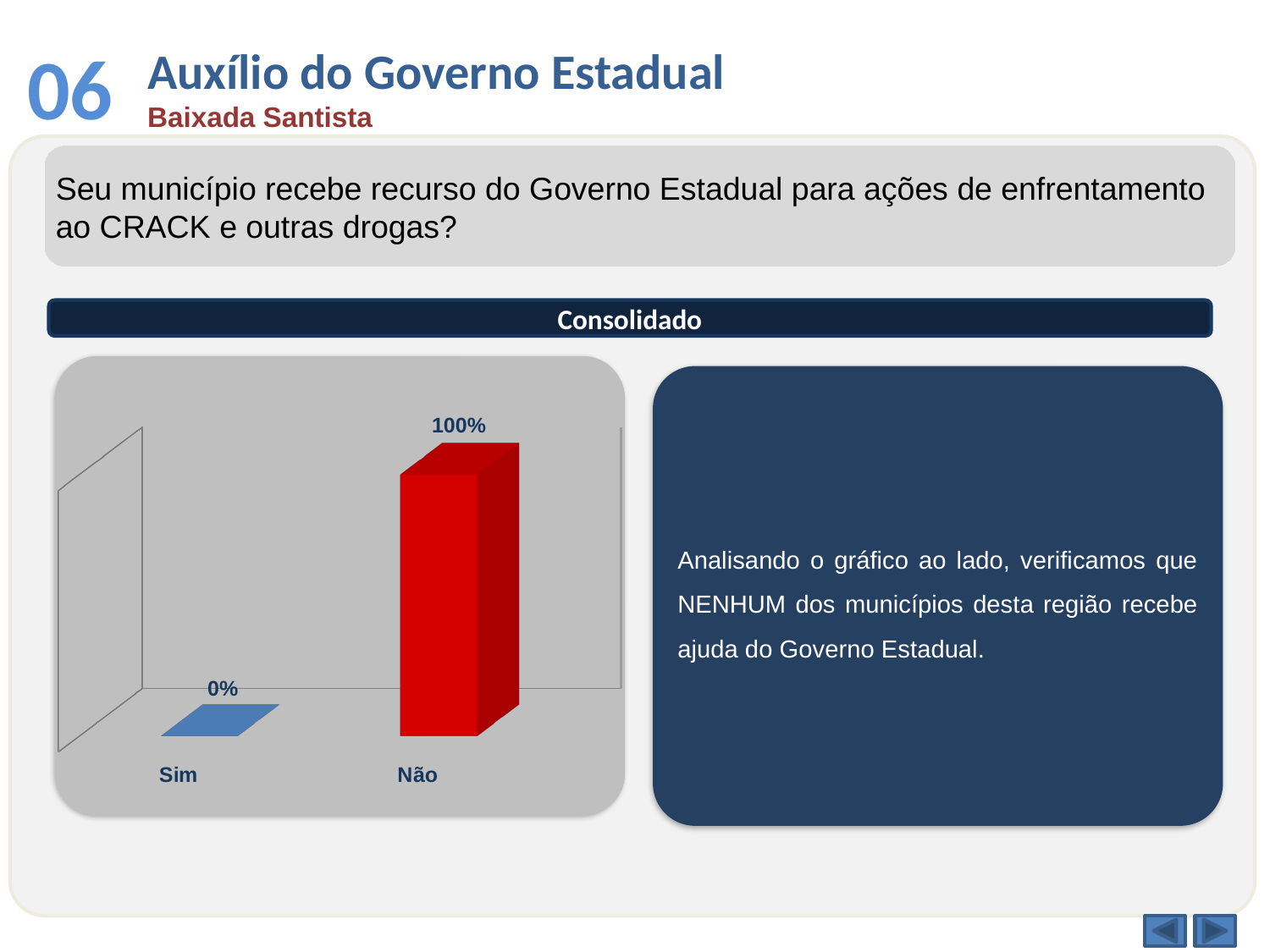
Which category has the lowest value? Sim What colour is the bar for Não? red What kind of chart is shown on the slide? bar chart What is the difference between the values for Não and Sim? 100% What is the heading above the chart? Consolidado How many categories are shown in the chart? 2 Which category has the highest value? Não What is the total of the values for Sim and Não? 100% Which is larger, the value for Sim or the value for Não? Não What is the value for Não? 100% What is the value for Sim? 0%